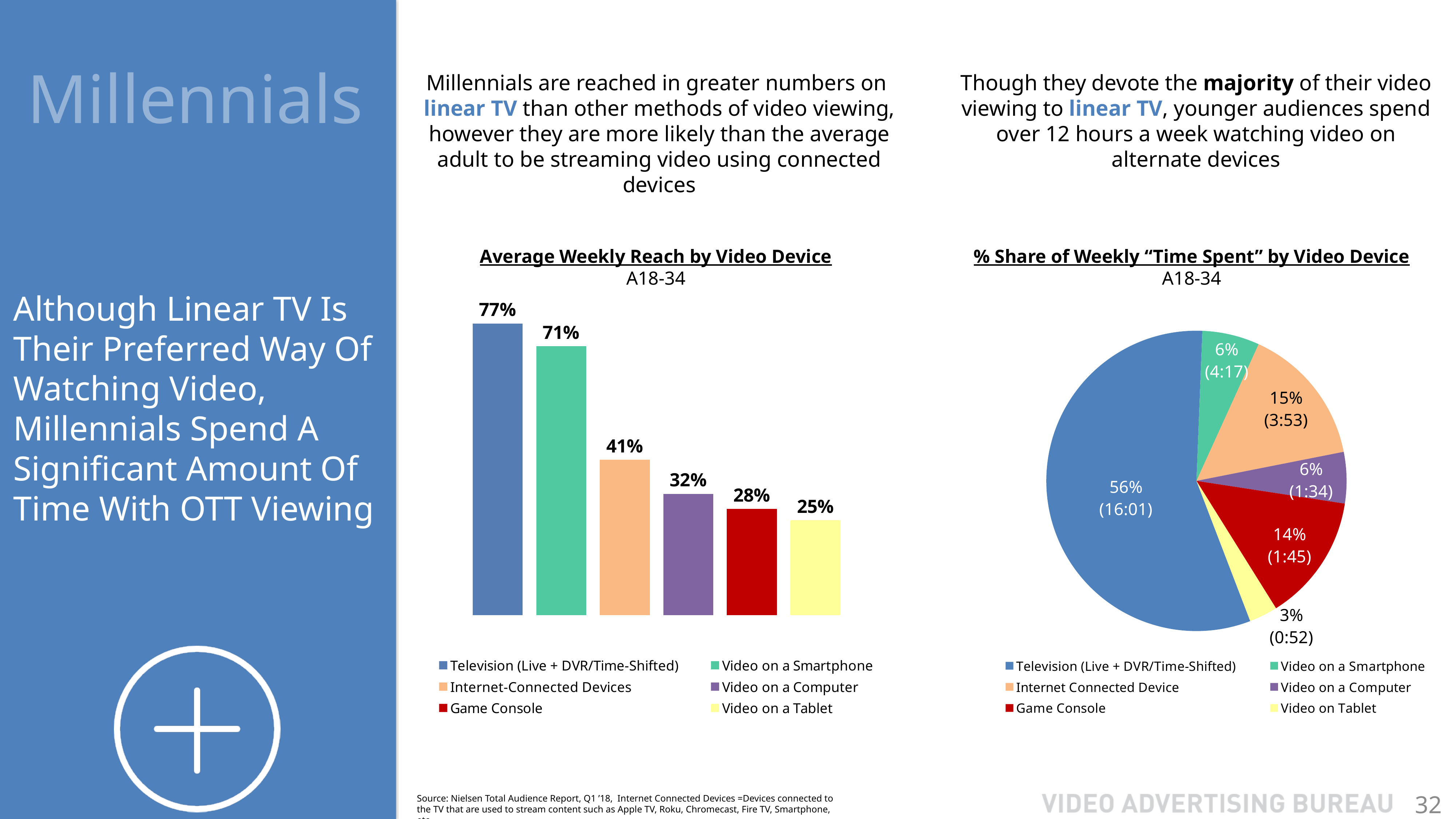
In the 'Average Weekly Reach by Video Device' chart, what is the value for Television (Live + DVR/Time-Shifted)? 77% What kind of chart is 'Average Weekly Reach by Video Device'? Bar chart In the '% Share of Weekly "Time Spent" by Video Device' chart, which device has the smallest share? Video on Tablet In the 'Average Weekly Reach by Video Device' chart, what is the value for Video on a Computer? 32% In the 'Average Weekly Reach by Video Device' chart, which is larger: Game Console or Video on a Tablet? Game Console In the '% Share of Weekly "Time Spent" by Video Device' chart, what share does Television (Live + DVR/Time-Shifted) have? 56% In the 'Average Weekly Reach by Video Device' chart, what is the difference between Video on a Smartphone and Internet-Connected Devices? 30% In the 'Average Weekly Reach by Video Device' chart, how many bars are plotted? 6 In the 'Average Weekly Reach by Video Device' chart, which device has the lowest reach? Video on a Tablet In the '% Share of Weekly "Time Spent" by Video Device' chart, what is the time shown for Game Console? 1:45 How many entries does the legend of the '% Share of Weekly "Time Spent" by Video Device' chart list? 6 In the 'Average Weekly Reach by Video Device' chart, do the values rise or fall from left to right? Fall